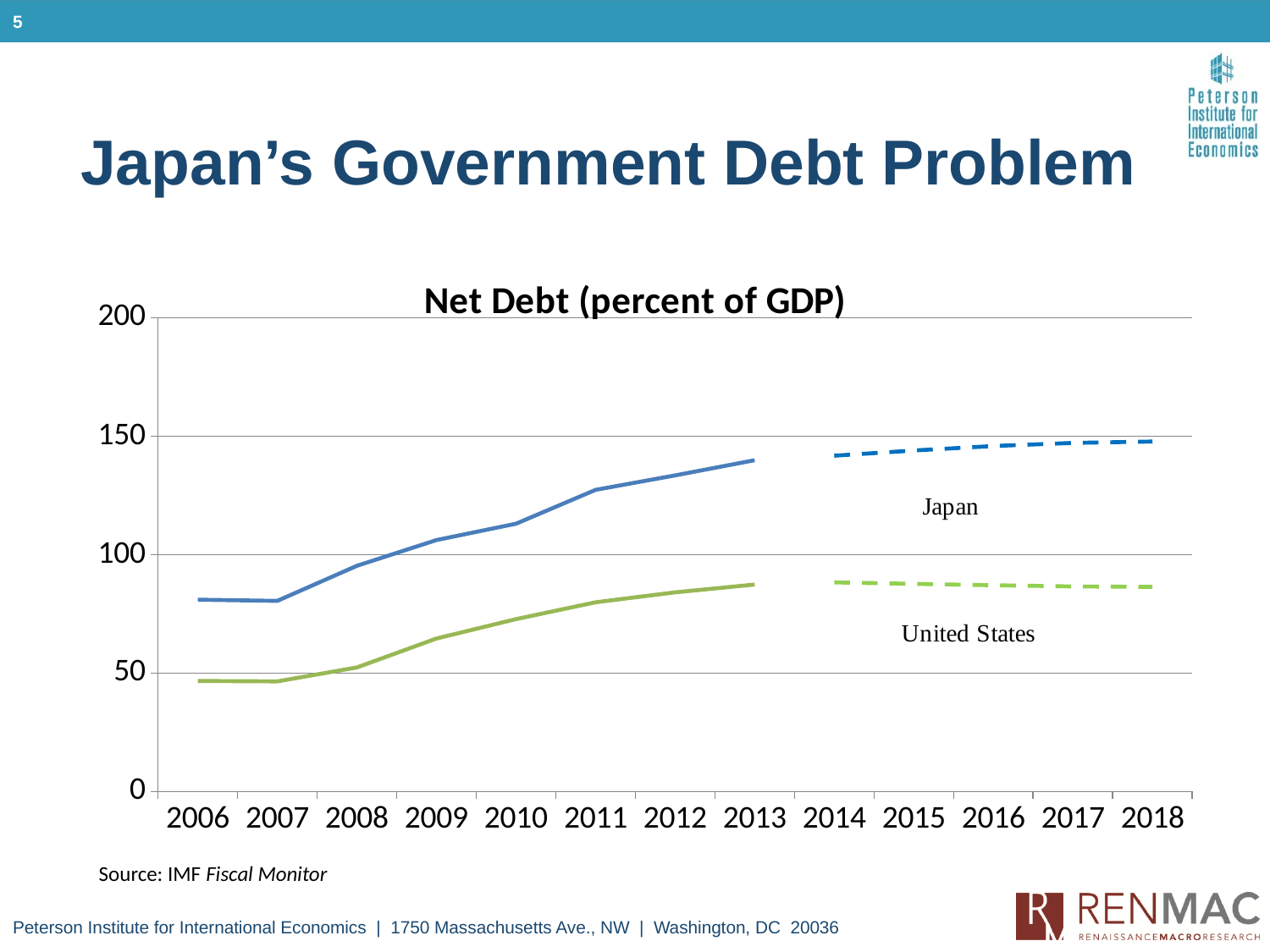
Is the value for Japan in 2013 greater or less than 100? greater Is the value for Japan in 2006 greater or less than 100? less Which two countries are plotted in the chart? Japan and United States Does Japan's net debt rise or fall from 2006 to 2013? rise Which country has the lower net debt in 2006? United States What type of chart is shown on the slide? line chart How many years are shown on the x axis? 13 Is the value for the United States in 2010 greater or less than 50? greater What is the title of the chart? Net Debt (percent of GDP) Which country has the higher net debt in 2013? Japan How many series are plotted in the chart? 2